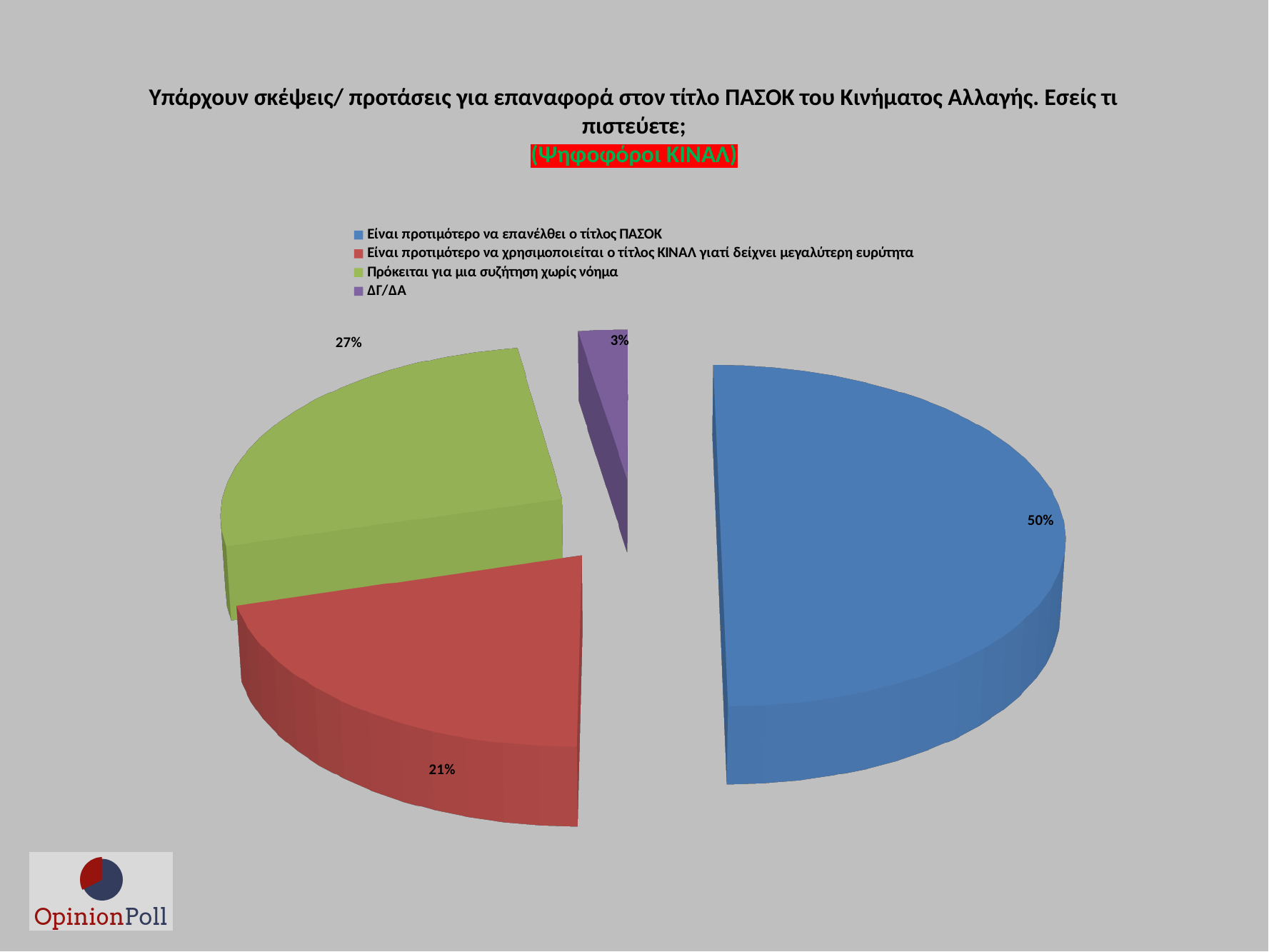
What is the difference in percentage points between the 'Πρόκειται για μια συζήτηση χωρίς νόημα' slice and the 'Είναι προτιμότερο να χρησιμοποιείται ο τίτλος ΚΙΝΑΛ γιατί δείχνει μεγαλύτερη ευρύτητα' slice? 6 percentage points Which category has the smallest slice of the pie? ΔΓ/ΔΑ What share of the pie is labelled for 'Είναι προτιμότερο να επανέλθει ο τίτλος ΠΑΣΟΚ'? 50% Which category has the largest slice of the pie? Είναι προτιμότερο να επανέλθει ο τίτλος ΠΑΣΟΚ What share of the pie is labelled for 'Πρόκειται για μια συζήτηση χωρίς νόημα'? 27% What share of the pie is labelled for 'ΔΓ/ΔΑ'? 3% What kind of chart is shown on the slide? Pie chart What colour is the slice for 'ΔΓ/ΔΑ'? Purple What share of the pie is labelled for 'Είναι προτιμότερο να χρησιμοποιείται ο τίτλος ΚΙΝΑΛ γιατί δείχνει μεγαλύτερη ευρύτητα'? 21% Which is larger: the slice for 'Πρόκειται για μια συζήτηση χωρίς νόημα' or the slice for 'Είναι προτιμότερο να χρησιμοποιείται ο τίτλος ΚΙΝΑΛ γιατί δείχνει μεγαλύτερη ευρύτητα'? Πρόκειται για μια συζήτηση χωρίς νόημα How many slices does the pie chart have? 4 Which group of voters does the chart subtitle say the results refer to? Ψηφοφόροι ΚΙΝΑΛ